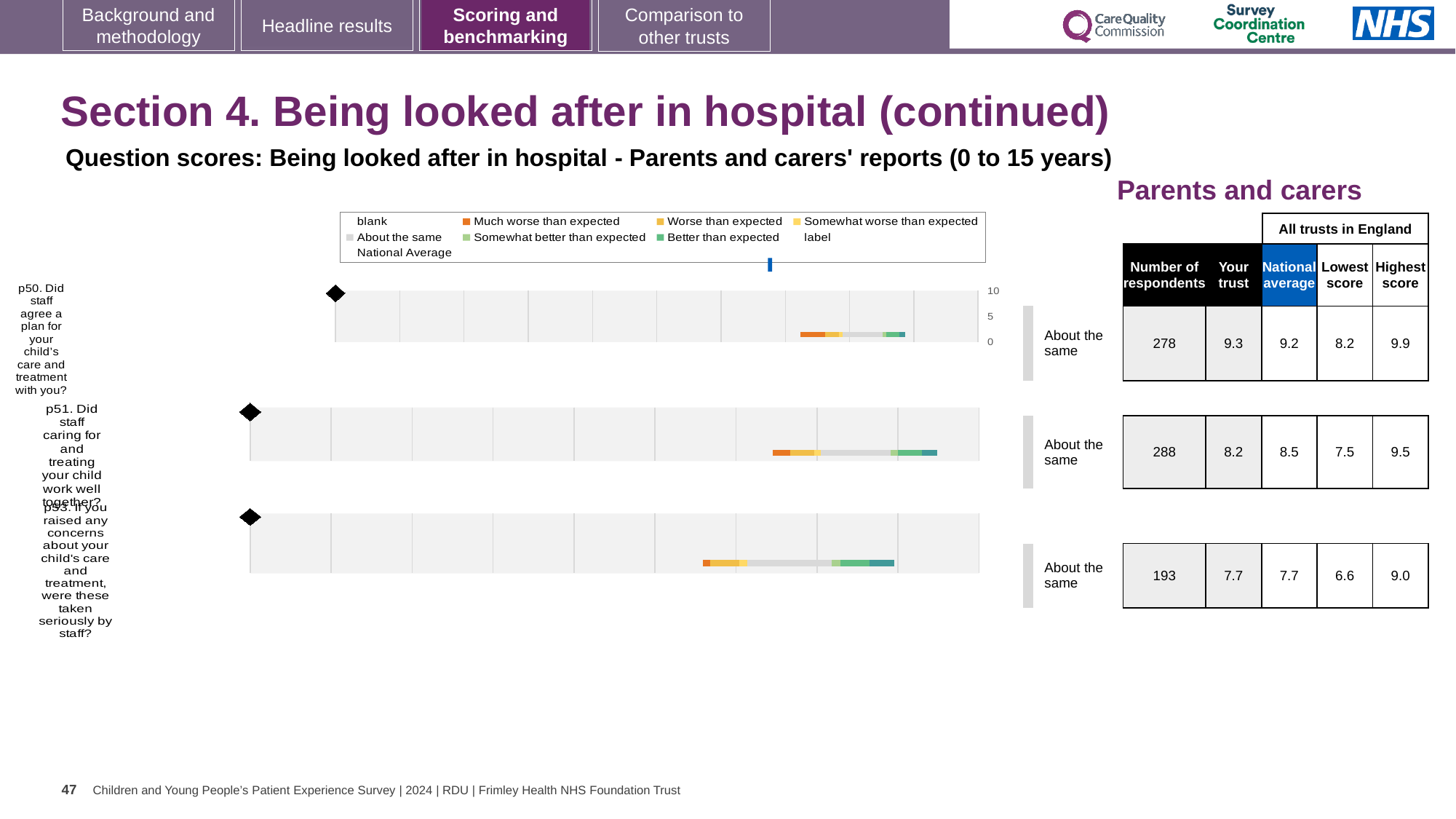
Which question has the highest 'Your trust' score in the table? p50 What benchmark rating is shown next to each of the three question charts? About the same For p51, which is larger: the 'Your trust' score or the national average? National average In the table, what is the national average score for p53 (If you raised any concerns about your child's care and treatment, were these taken seriously by staff)? 7.7 In the table, what is the highest score among all trusts in England for p50? 9.9 How many questions (p50, p51, p53) are plotted on the slide? 3 In the table, what is the 'Your trust' score for p51 (Did staff caring for and treating your child work well together)? 8.2 What is the difference between the highest score (9.9) and the lowest score (8.2) for p50 in the table? 1.7 What kind of chart is used to show the question scores on this slide? bar chart In the table, what is the number of respondents for p50 (Did staff agree a plan for your child's care and treatment with you)? 278 Which question has the lowest 'Your trust' score in the table? p53 What is the subtitle describing the question scores shown on this slide? Question scores: Being looked after in hospital - Parents and carers' reports (0 to 15 years)